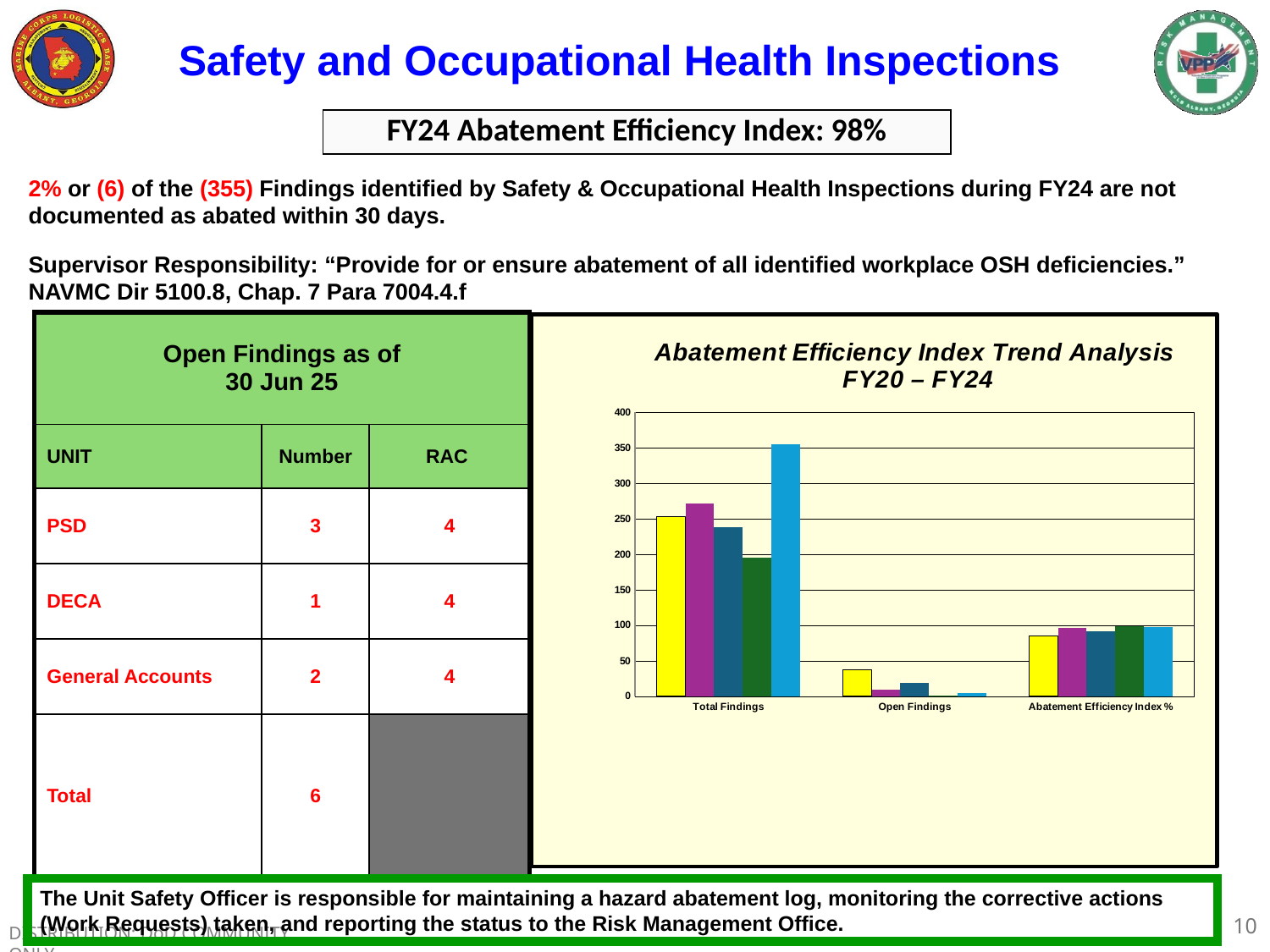
In the Total Findings category, which coloured bar is the shortest? dark green Is the yellow bar for Open Findings greater or less than 50? less Is the light blue bar for Total Findings greater or less than 300? greater What is the highest value shown on the chart's y axis? 400 How many bars are plotted in each category of the chart? 5 Which category has the tallest bars overall: Total Findings, Open Findings, or Abatement Efficiency Index %? Total Findings In the Total Findings category, which coloured bar is the tallest? light blue In the Open Findings category, which coloured bar is the tallest? yellow What kind of chart is shown on the slide? bar chart What is the title of the chart on the slide? Abatement Efficiency Index Trend Analysis FY20 – FY24 How many categories are shown along the x axis of the chart? 3